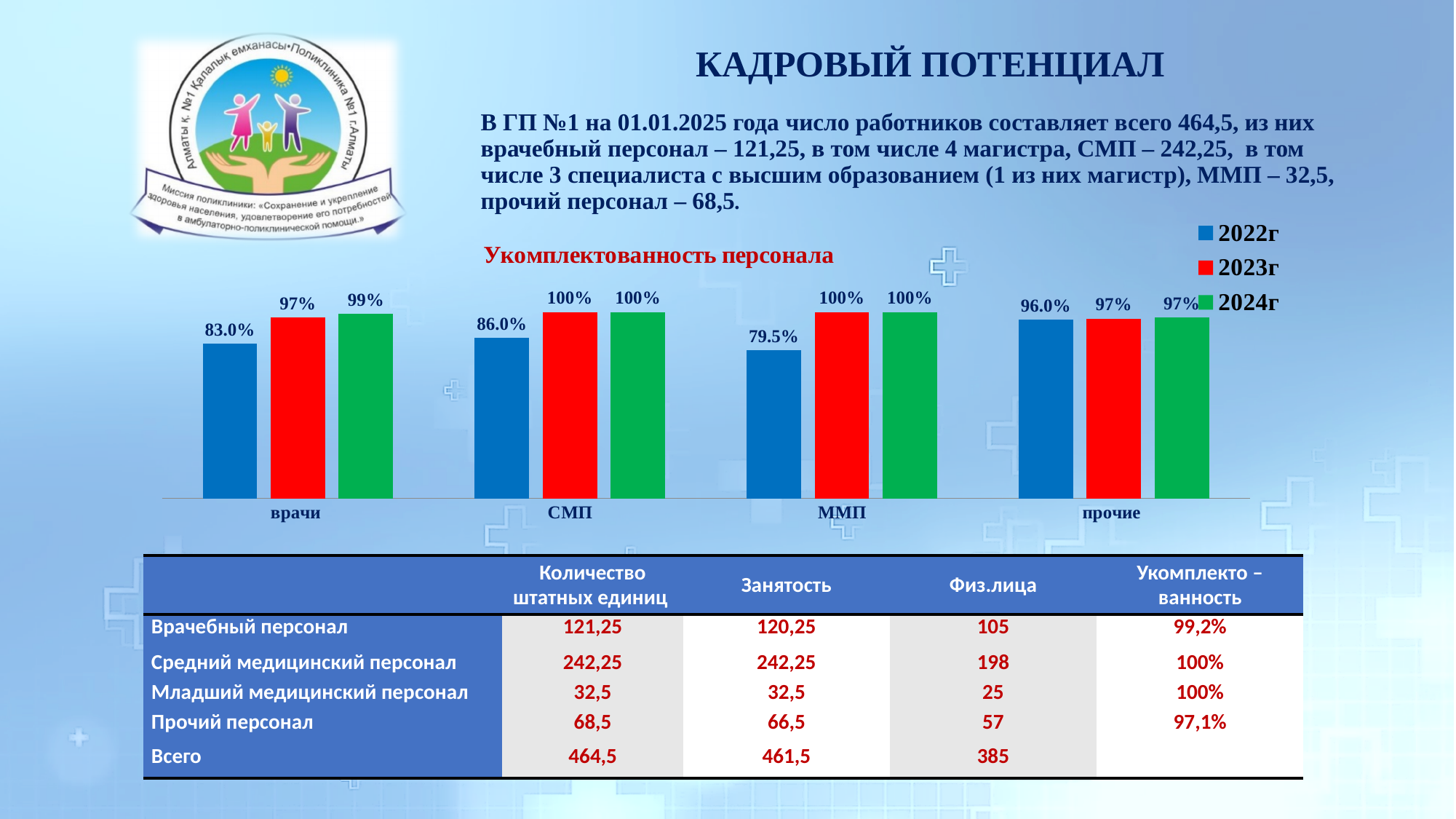
What is the value for СМП in 2023г? 100% What type of chart is shown under the heading "Укомплектованность персонала"? bar chart Which category has the highest value in the 2022г series? прочие What is the value for прочие in 2024г? 97% Which category has the lowest value in the 2022г series? ММП How many categories are shown on the x axis of the chart? 4 What is the value for ММП in 2022г? 79.5% How many series does the legend of the chart list? 3 What is the value for врачи in 2022г? 83.0% What is the difference between the 2024г and 2022г values for врачи? 16% Which is larger: the 2022г value for СМП or the 2022г value for врачи? СМП Do the values for ММП rise or fall from 2022г to 2023г? rise